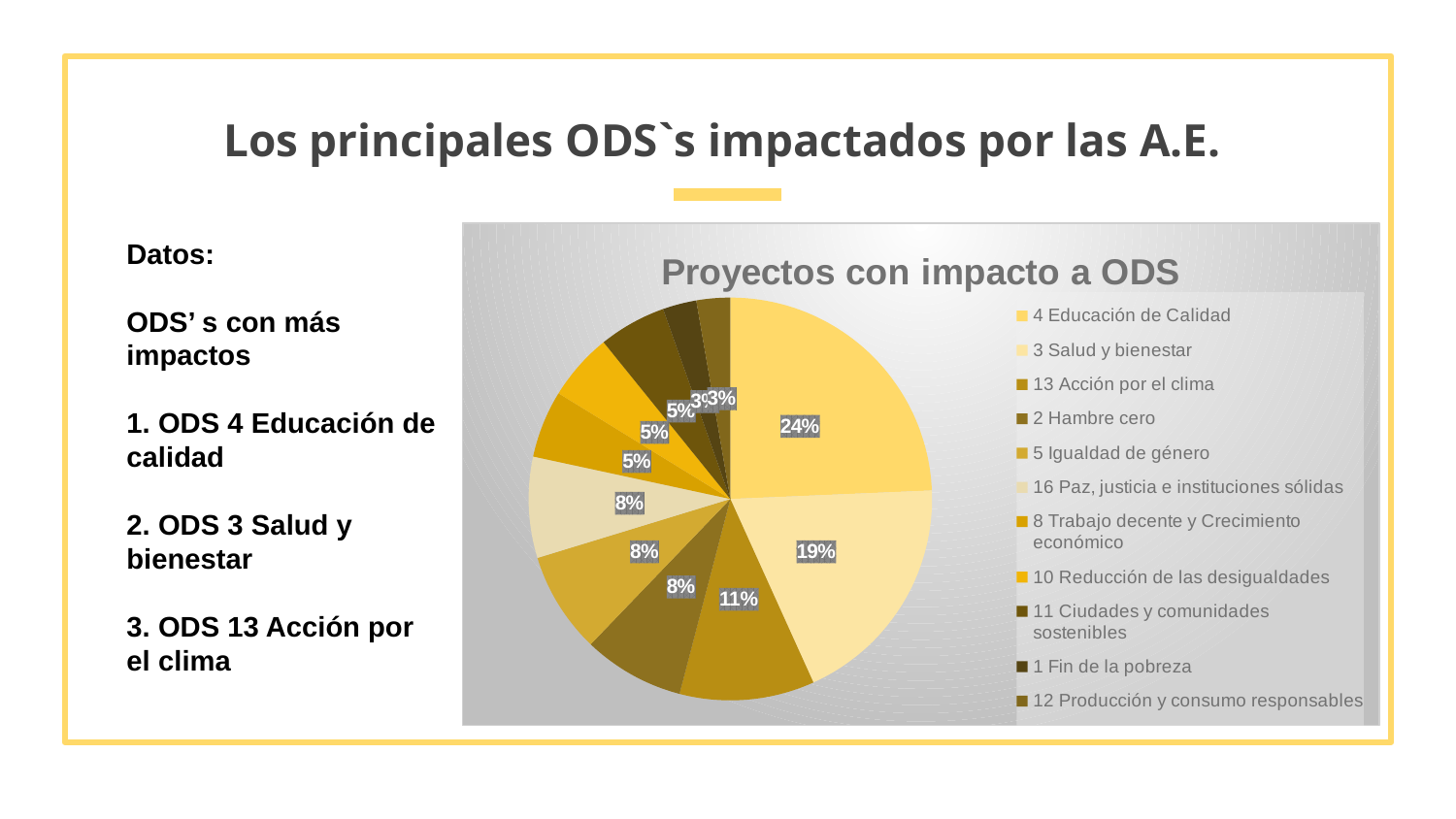
Which category has the largest slice of the pie? 4 Educación de Calidad How many categories does the legend of the pie chart list? 11 What is the value shown for '13 Acción por el clima'? 11% What share of the pie does '4 Educación de Calidad' represent? 24% Which legend entry is listed first in the chart's legend? 4 Educación de Calidad What is the difference in percentage points between '4 Educación de Calidad' and '3 Salud y bienestar'? 5 What is the value shown for '2 Hambre cero'? 8% Which is larger, the slice for '3 Salud y bienestar' or the slice for '13 Acción por el clima'? 3 Salud y bienestar What is the title of the chart? Proyectos con impacto a ODS What type of chart is shown on the slide? pie chart What is the value shown for '3 Salud y bienestar'? 19% What is the smallest percentage labelled on the pie chart? 3%